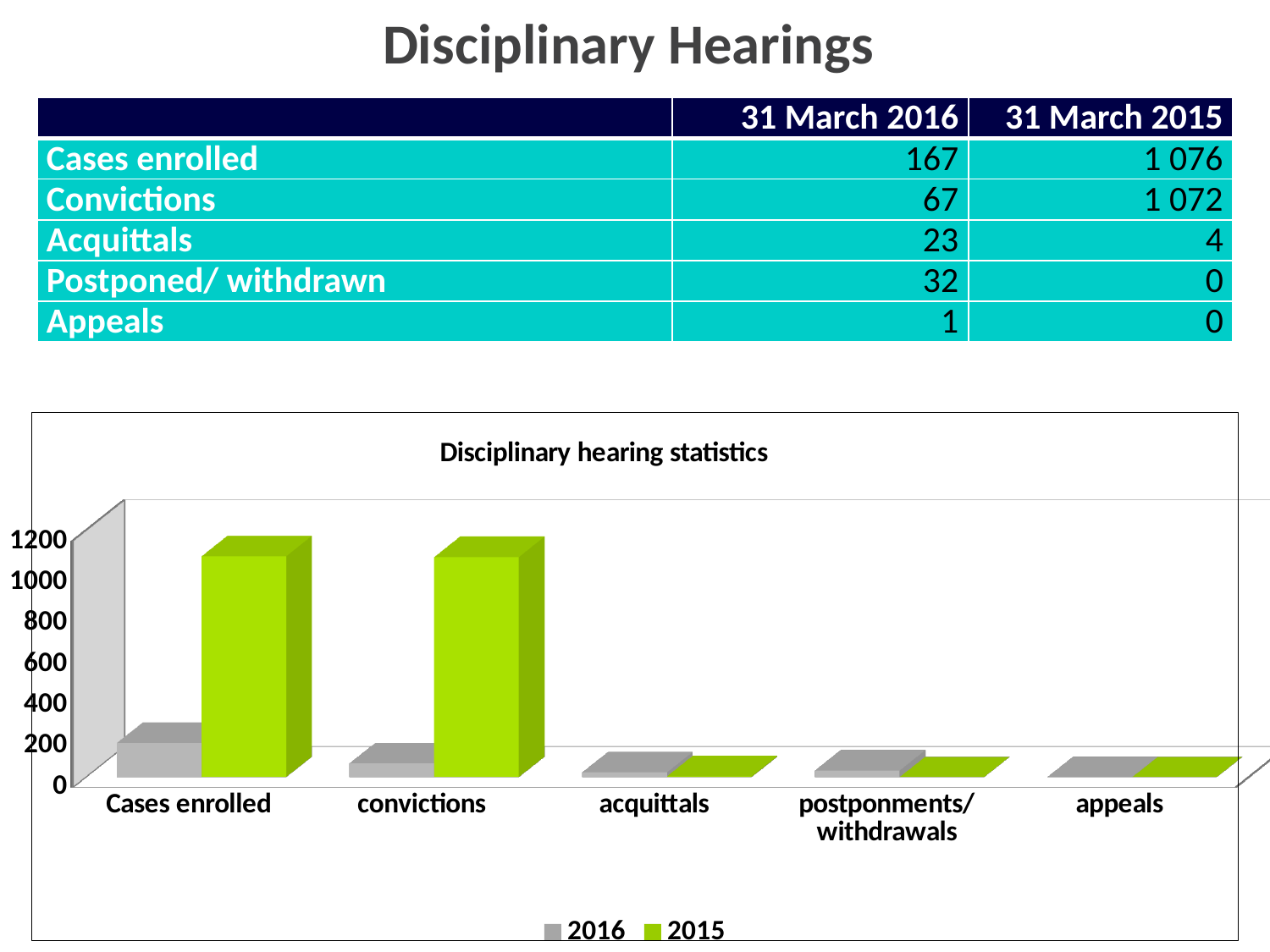
Is the 2015 value for convictions greater or less than 800? greater Is the 2016 value for convictions greater or less than 200? less Is the 2015 value for acquittals greater or less than 200? less For Cases enrolled, which series has the larger value, 2016 or 2015? 2015 What kind of chart is shown on the slide? bar chart Which category has the highest value for the 2016 series? Cases enrolled Which colour represents the 2015 series in the chart? green What is the title of the chart? Disciplinary hearing statistics How many series does the chart legend list? 2 How many categories are shown on the x axis of the chart? 5